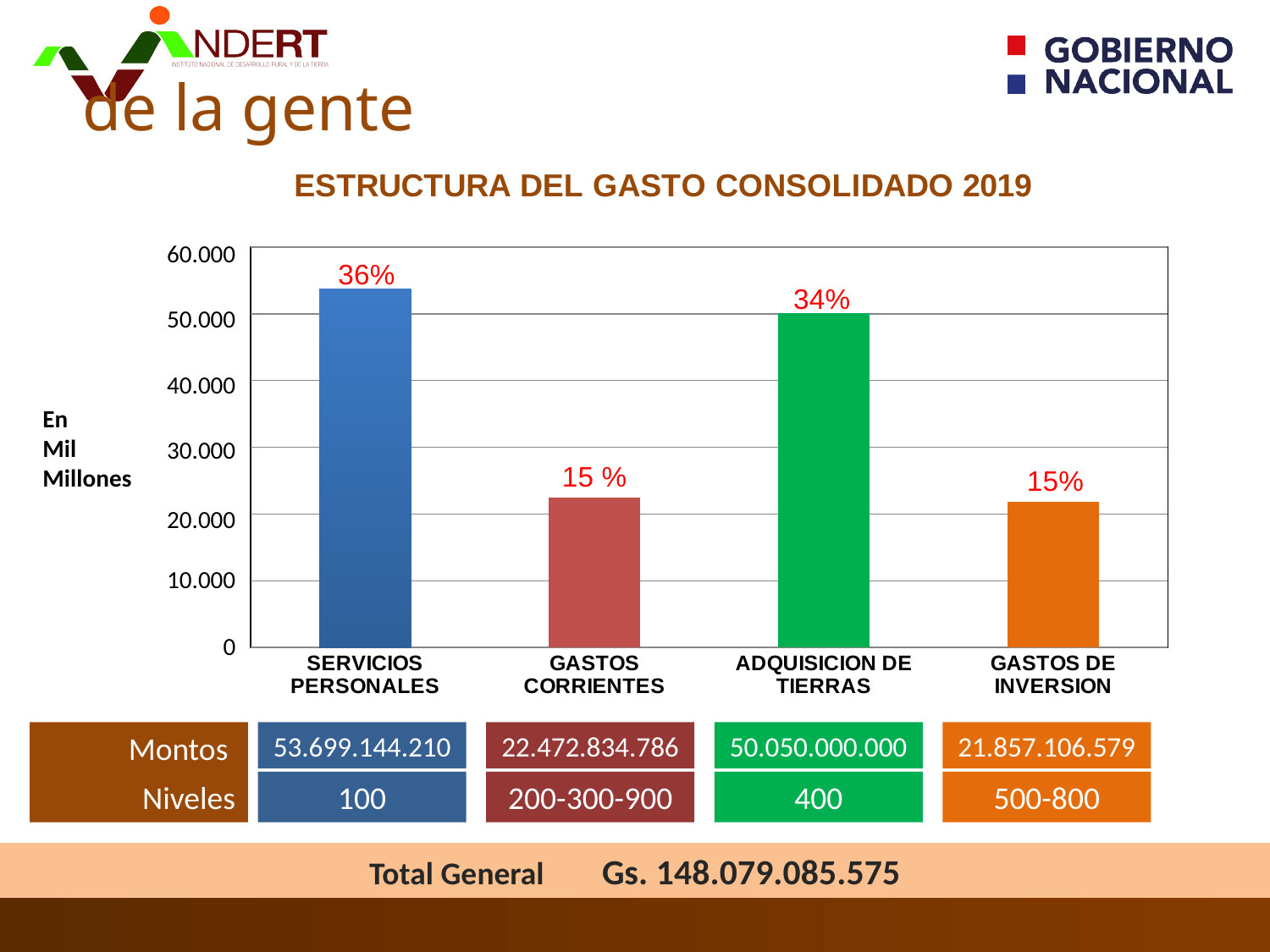
What percentage label is shown on the bar for ADQUISICION DE TIERRAS? 34% Is the value for GASTOS CORRIENTES greater or less than 30.000? less Is the value for ADQUISICION DE TIERRAS greater or less than 40.000? greater What percentage label is shown on the bar for GASTOS DE INVERSION? 15% What is the difference in percentage points between the labels for SERVICIOS PERSONALES and ADQUISICION DE TIERRAS? 2% Which is larger, the value for SERVICIOS PERSONALES or the value for ADQUISICION DE TIERRAS? SERVICIOS PERSONALES How many categories are shown on the x axis of the chart? 4 Which category has the highest bar in the chart? SERVICIOS PERSONALES What kind of chart is shown on the slide? bar chart What percentage label is shown on the bar for SERVICIOS PERSONALES? 36% Is the value for SERVICIOS PERSONALES greater or less than 50.000? greater What is the title of the chart? ESTRUCTURA DEL GASTO CONSOLIDADO 2019